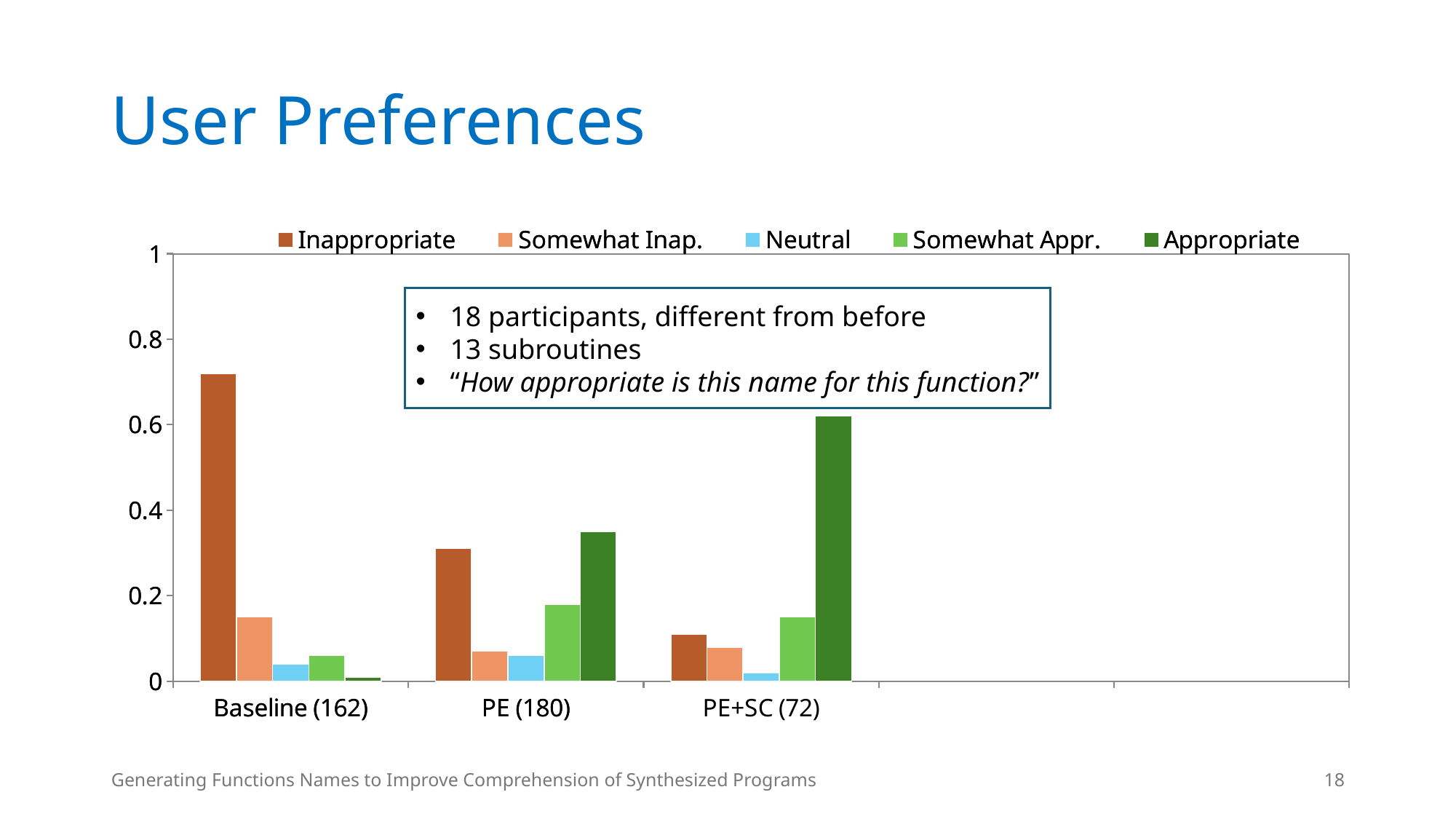
Which series has the lowest value for Baseline (162)? Appropriate What kind of chart is shown on the slide? Bar chart Which category has the highest Inappropriate value? Baseline (162) Does the Inappropriate value rise or fall across the categories from Baseline (162) to PE+SC (72)? Fall Which series has the highest value for PE+SC (72)? Appropriate How many series does the legend list? 5 What colour represents the Neutral series in the legend? Light blue Which series has the highest value for Baseline (162)? Inappropriate How many categories are shown on the x axis? 3 Is the Appropriate value for PE (180) greater or less than 0.4? less Is the Inappropriate value for Baseline (162) greater or less than 0.6? greater Which is larger for PE (180): the Inappropriate value or the Somewhat Appr. value? Inappropriate